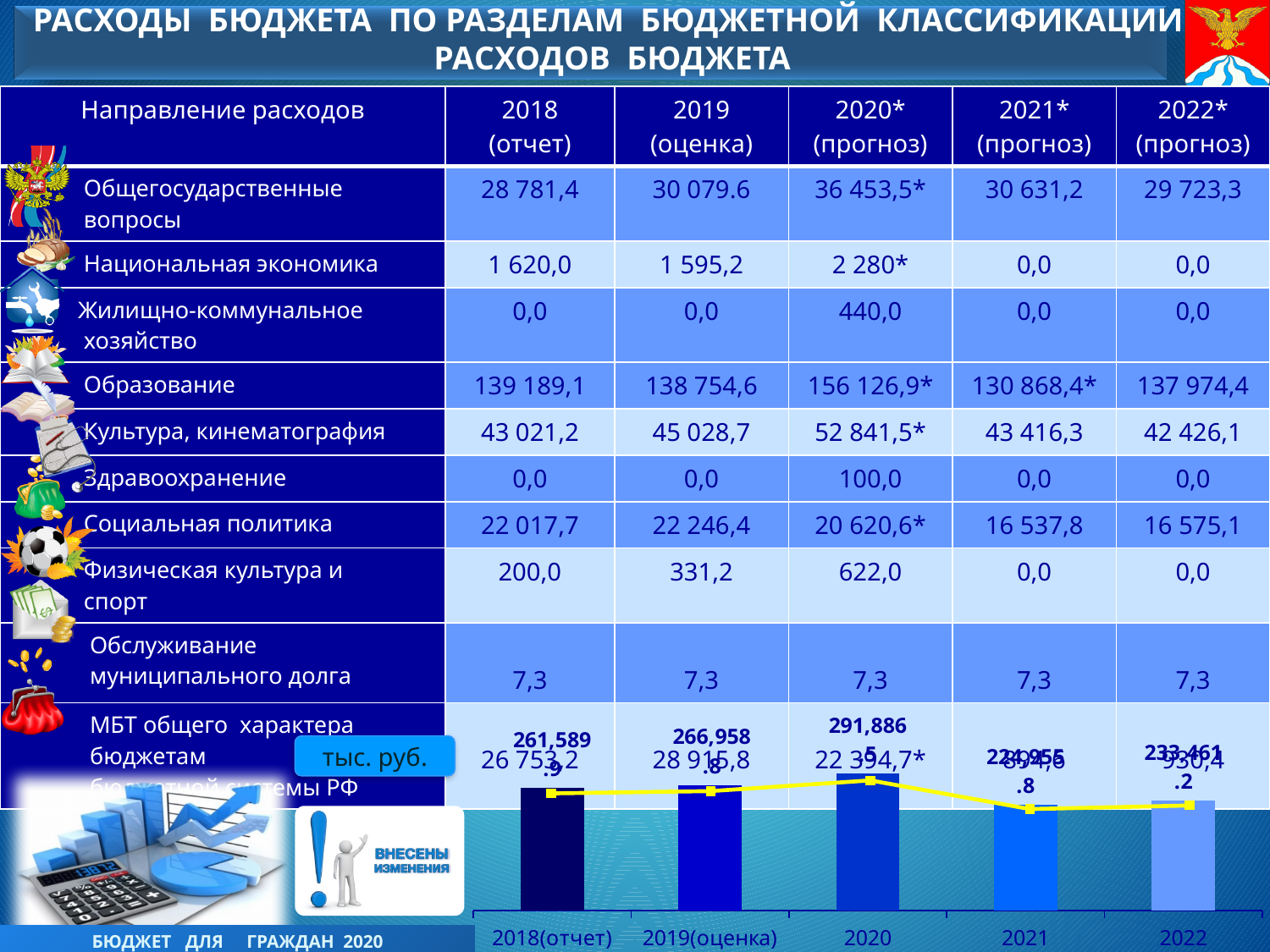
In the chart at the bottom of the slide, what is the difference between the 2020 value and the 2019(оценка) value? 24,927.7 In the chart at the bottom of the slide, what is the value labelled for 2018(отчет)? 261,589.9 How many bars does the chart at the bottom of the slide have? 5 In the chart at the bottom of the slide, which year has the highest value? 2020 In the chart at the bottom of the slide, do the values rise or fall from 2018(отчет) to 2020? rise In the chart at the bottom of the slide, what is the value labelled for 2019(оценка)? 266,958.8 What kind of chart is shown at the bottom of the slide? bar chart In the chart at the bottom of the slide, what is the value labelled for 2020? 291,886.5 In the chart at the bottom of the slide, what is the difference between the 2019(оценка) value and the 2018(отчет) value? 5,368.9 In the chart at the bottom of the slide, which is larger: the value for 2020 or for 2021? 2020 What unit is shown in the label next to the chart at the bottom of the slide? тыс. руб. In the chart at the bottom of the slide, which is larger: the value for 2018(отчет) or for 2019(оценка)? 2019(оценка)